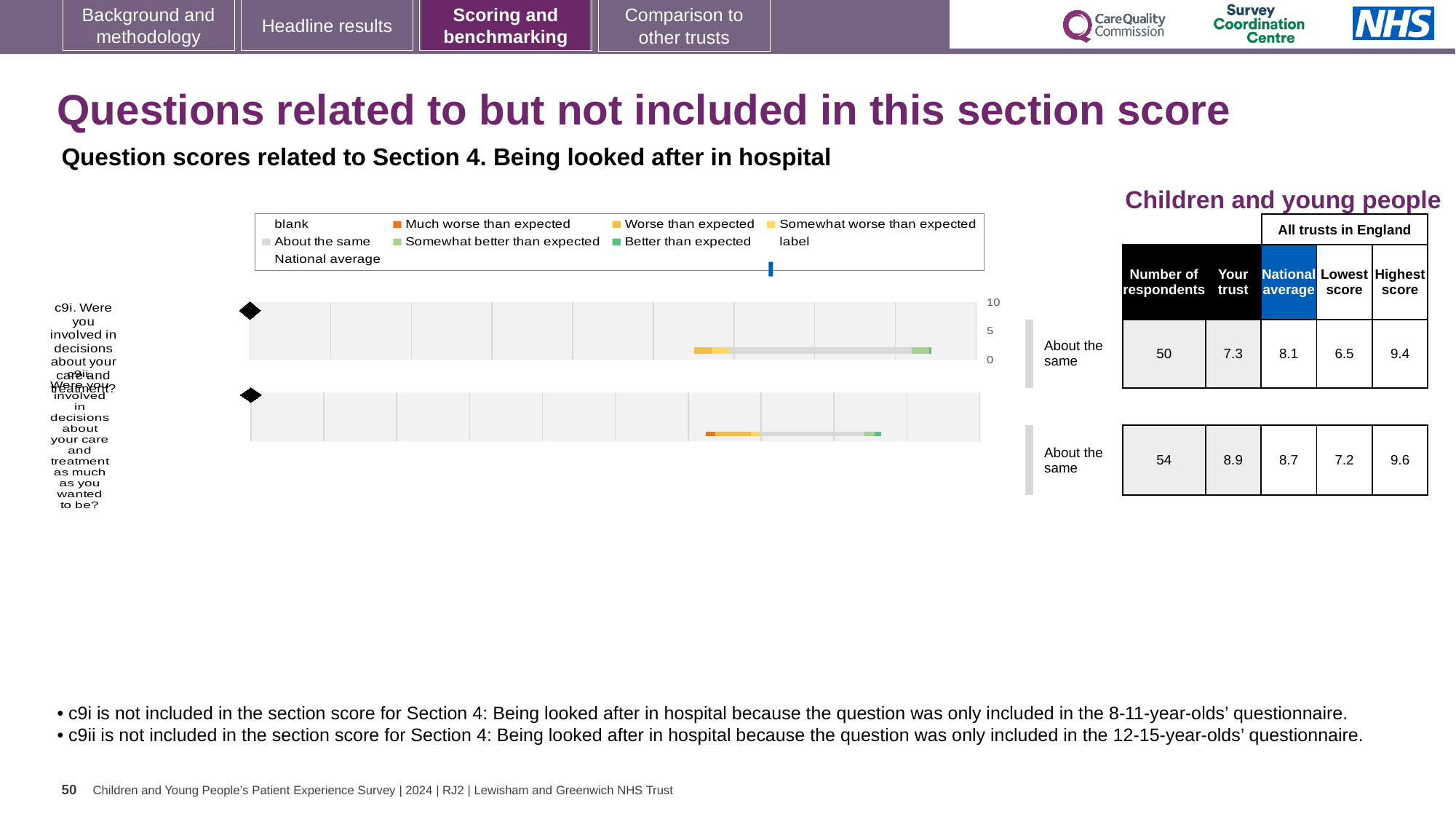
For c9i, is the Your trust score or the National average score larger? National average What benchmark category is shown next to the c9i bar? About the same How many respondents answered c9ii? 54 What is the difference between the Highest score and the Lowest score for c9ii? 2.4 How many questions (bars) are plotted on the slide? 2 What is the Highest score across all trusts in England for c9i? 9.4 What is the Your trust score for c9i? 7.3 What kind of chart is used to show the c9i and c9ii question scores? bar chart Is the Your trust score for c9ii greater or less than 5? greater What is the National average score for c9ii? 8.7 Which question has the higher Your trust score, c9i or c9ii? c9ii What is the difference between the National average and the Your trust score for c9i? 0.8